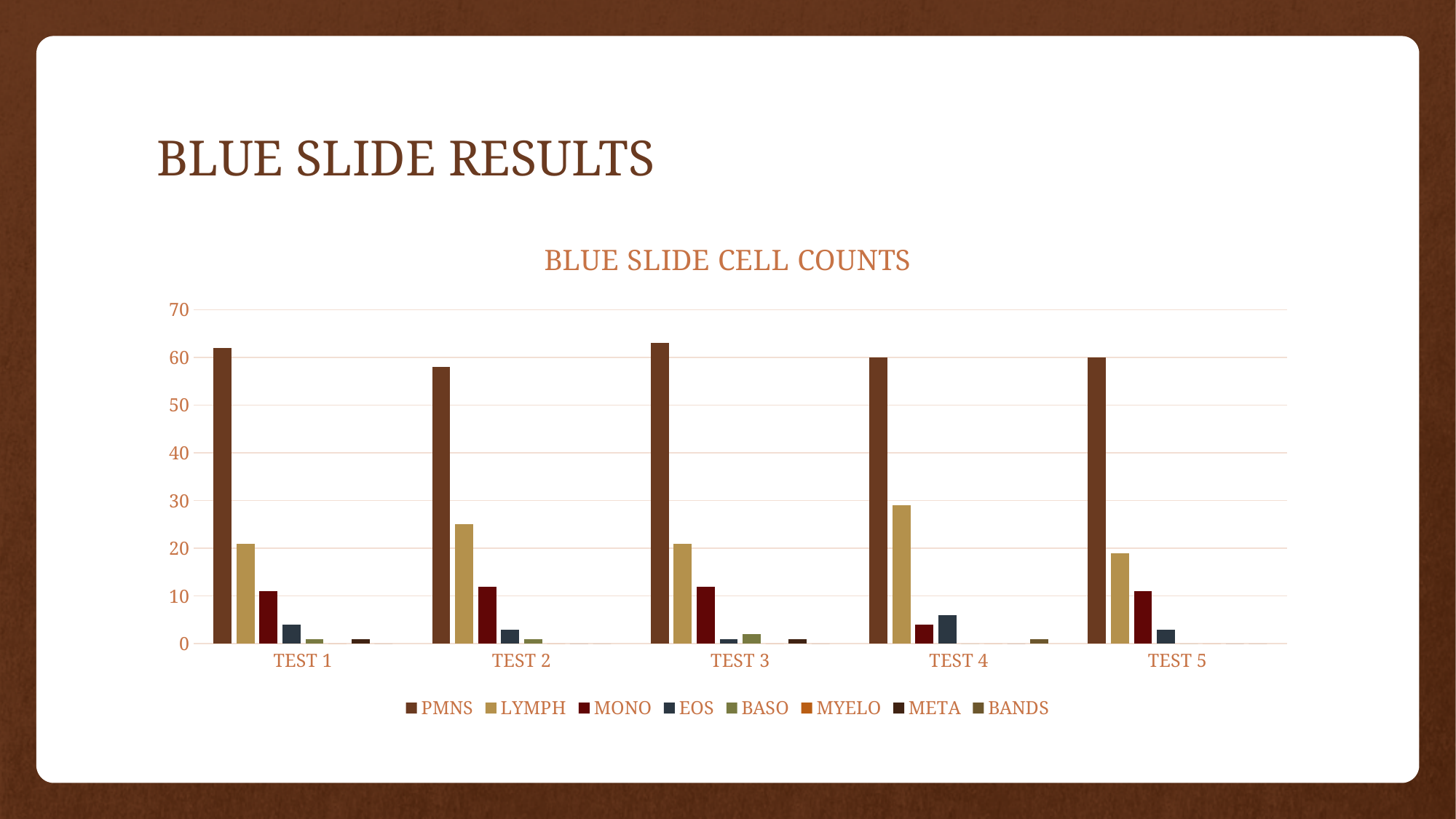
What is the title of the chart? BLUE SLIDE CELL COUNTS Is the EOS value for TEST 4 greater or less than 10? less In which test is the LYMPH bar highest? TEST 4 Which is larger, the LYMPH value for TEST 4 or the LYMPH value for TEST 2? TEST 4 What kind of chart is shown on the slide? bar chart Is the LYMPH value for TEST 2 greater or less than 20? greater In TEST 1, which is larger, the MONO bar or the EOS bar? MONO How many series does the legend list? 8 How many test categories are shown on the x axis? 5 Is the PMNS value for TEST 1 greater or less than 50? greater Which series has the tallest bar in every test? PMNS